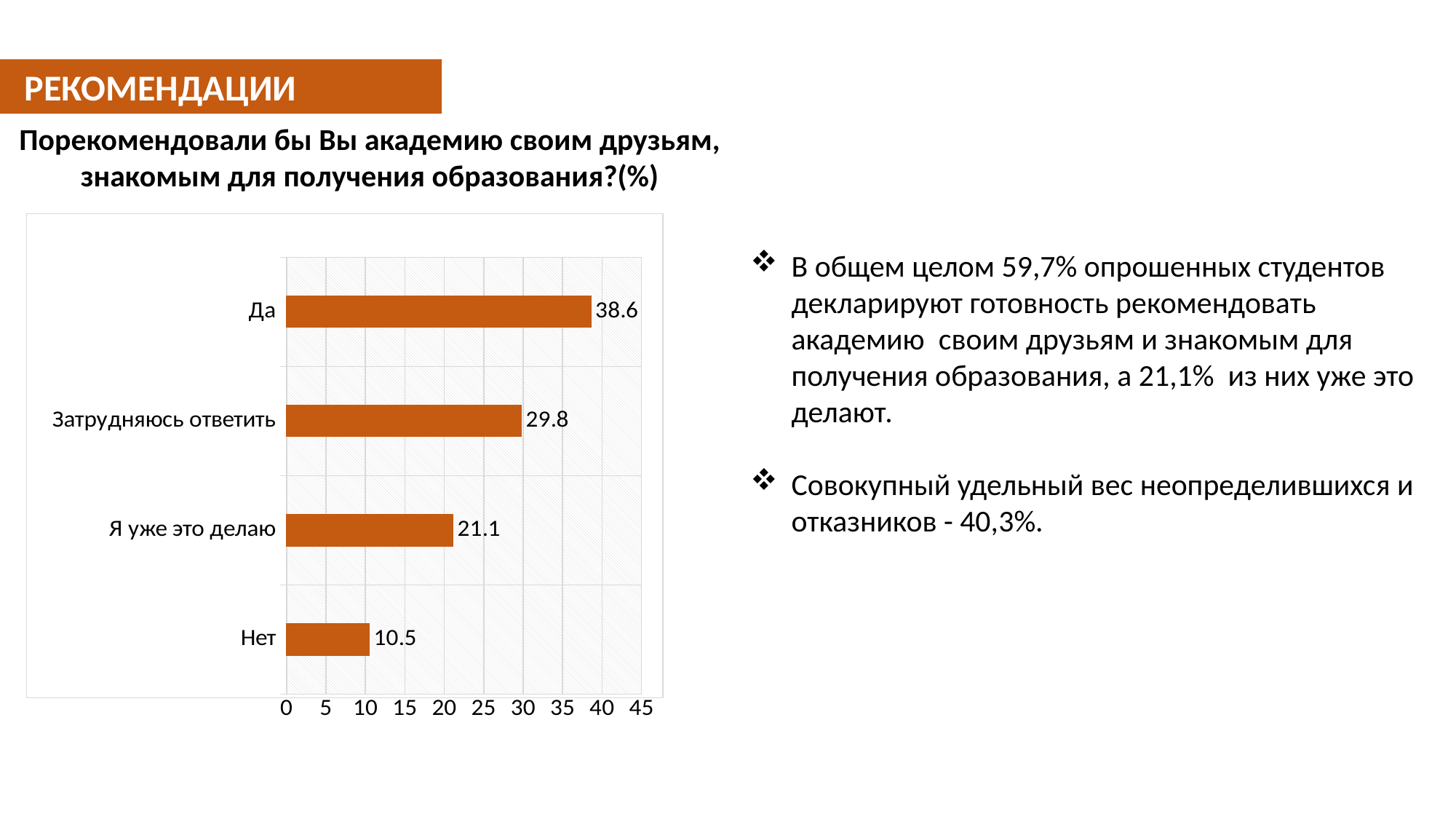
What kind of chart is shown on the slide? bar chart What is the value for "Затрудняюсь ответить"? 29.8 Which category has the highest value? Да What is the value for "Да"? 38.6 What is the value for "Я уже это делаю"? 21.1 Is the value for "Да" greater or less than 35? greater What is the value for "Нет"? 10.5 Which category has the lowest value? Нет What is the difference between the values for "Да" and "Нет"? 28.1 How many categories are shown in the chart? 4 What is the maximum value shown on the chart's value axis? 45 Which is larger, the value for "Затрудняюсь ответить" or the value for "Я уже это делаю"? Затрудняюсь ответить